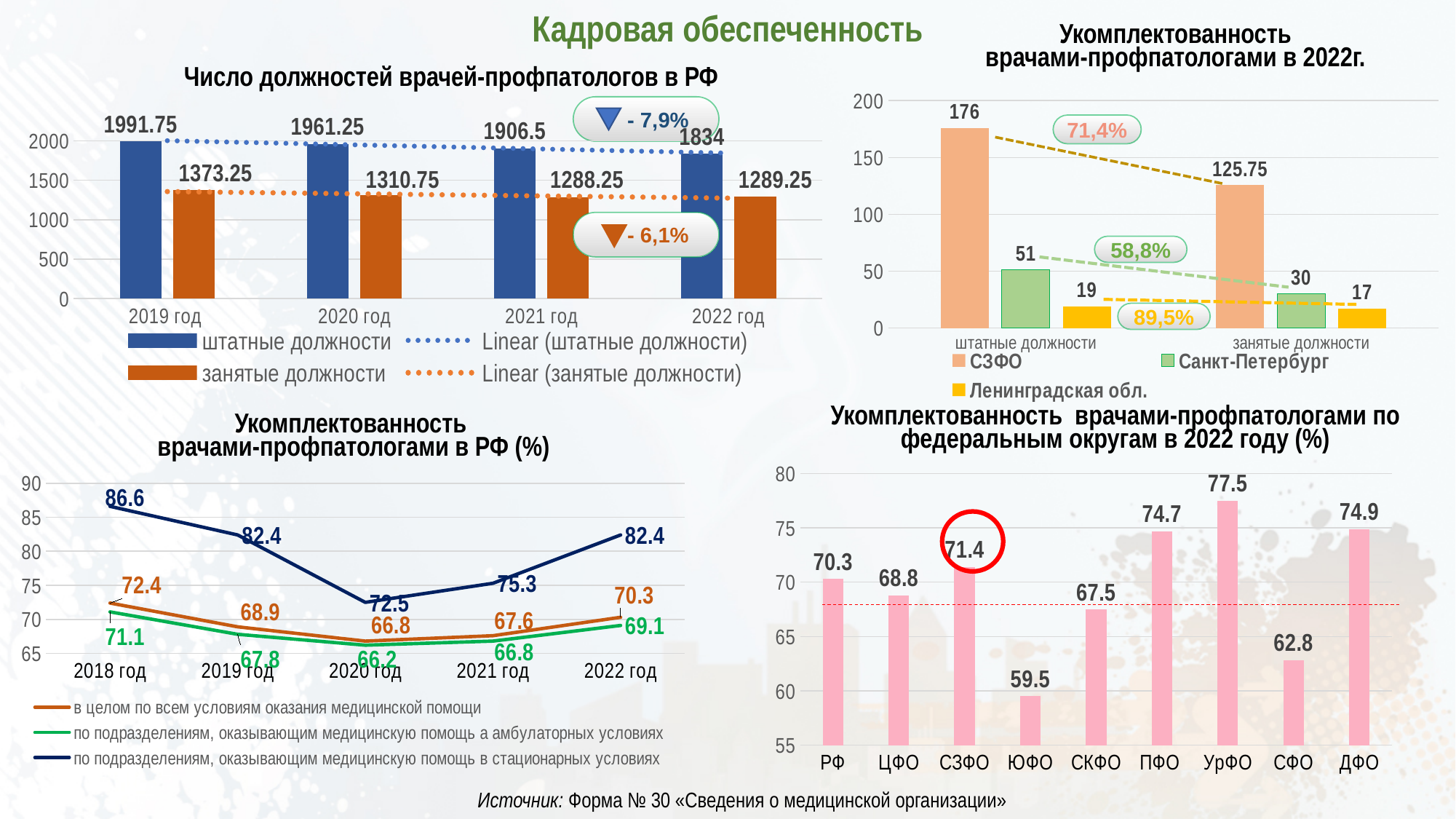
In the chart 'Число должностей врачей-профпатологов в РФ', do the штатные должности values rise or fall from 2019 год to 2022 год? fall In the chart 'Укомплектованность врачами-профпатологами в РФ (%)', which year has the lowest value in the series 'по подразделениям, оказывающим медицинскую помощь а амбулаторных условиях'? 2020 год In the chart 'Укомплектованность врачами-профпатологами по федеральным округам в 2022 году (%)', which federal district has the highest value? УрФО In the chart 'Укомплектованность врачами-профпатологами в РФ (%)', what is the value for 2020 год in the series 'по подразделениям, оказывающим медицинскую помощь в стационарных условиях'? 72.5 In the chart 'Число должностей врачей-профпатологов в РФ', what is the value of штатные должности for 2022 год? 1834 In the chart 'Укомплектованность врачами-профпатологами по федеральным округам в 2022 году (%)', which is larger, the value for ЮФО or the value for СФО? СФО In the chart 'Укомплектованность врачами-профпатологами в 2022г.', how many series does the legend list? 3 In the chart 'Укомплектованность врачами-профпатологами по федеральным округам в 2022 году (%)', how many categories are shown on the x axis? 9 What kind of chart is 'Укомплектованность врачами-профпатологами в РФ (%)'? line chart In the chart 'Число должностей врачей-профпатологов в РФ', what is the difference between штатные должности and занятые должности in 2019 год? 618.5 In the chart 'Укомплектованность врачами-профпатологами в 2022г.', which series has the highest value for штатные должности? СЗФО In the chart 'Укомплектованность врачами-профпатологами в 2022г.', what is the value for Санкт-Петербург in занятые должности? 30